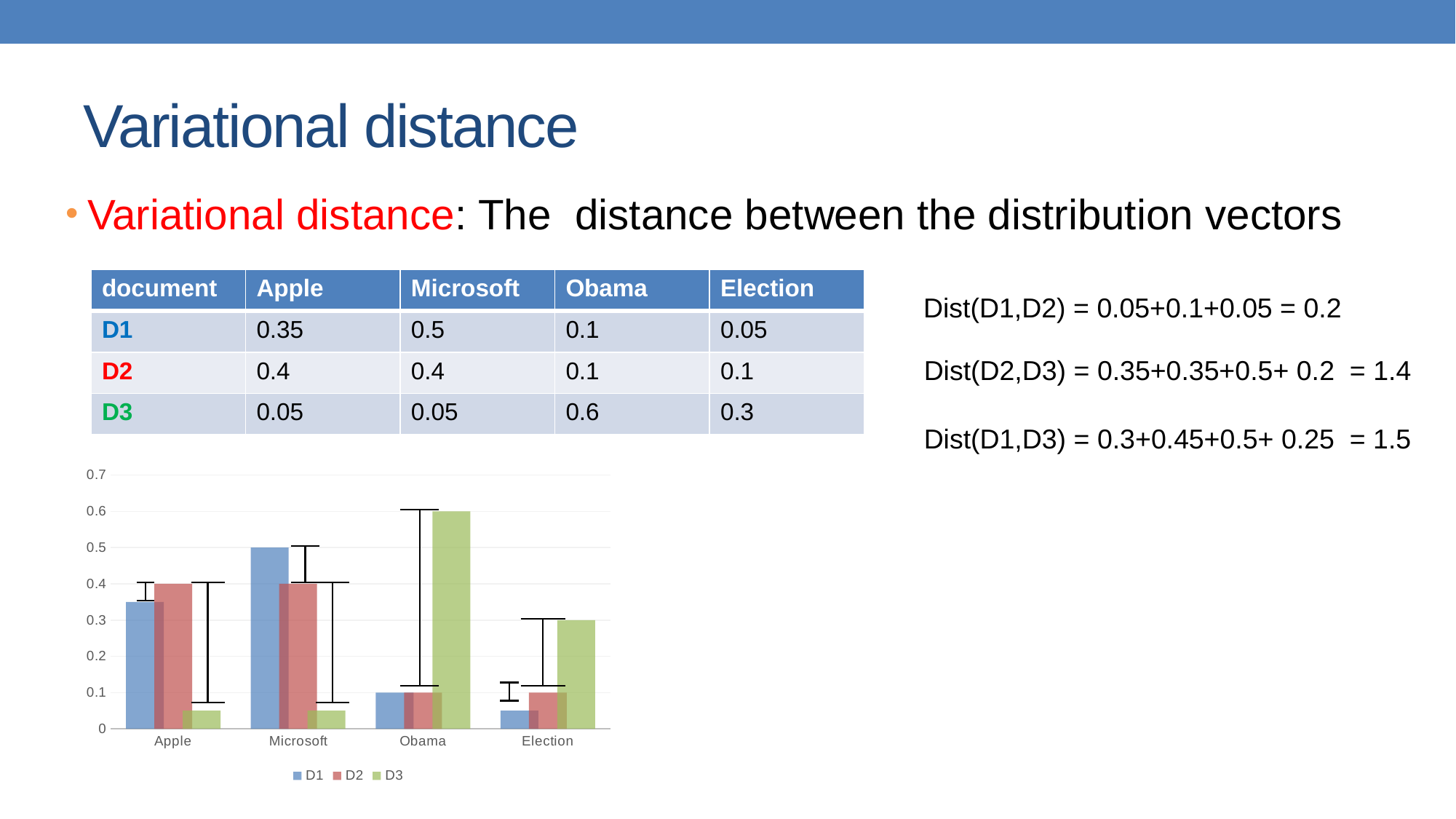
How many categories are shown on the x axis of the chart? 4 What is the value of D2 for Apple in the chart? 0.4 What is the difference between the D1 and D2 values for Microsoft? 0.1 What is the value of D1 for Microsoft in the chart? 0.5 For Microsoft, which is larger: the D1 value or the D2 value? D1 What kind of chart is shown on the slide? bar chart Is the value of D1 for Apple greater or less than 0.3? greater Which series has the lowest value for Apple? D3 How many series does the chart's legend list? 3 What is the value of D3 for Election in the chart? 0.3 For which category is the D3 value highest? Obama What is the value of D3 for Obama in the chart? 0.6